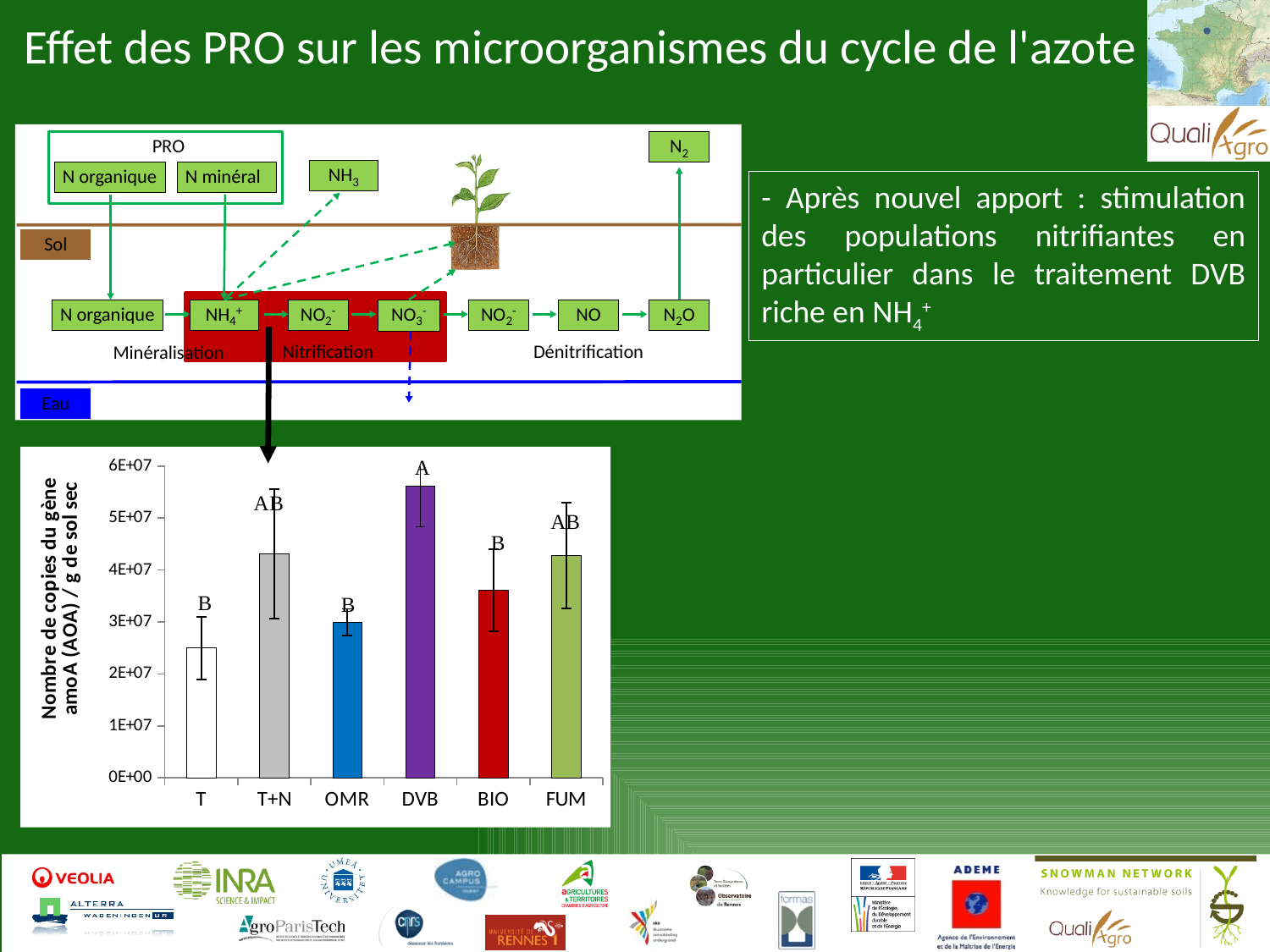
Is the value for BIO greater or less than 3E+07? greater Which treatment has the highest number of amoA gene copies in the bar chart? DVB Which has a larger value in the bar chart, DVB or BIO? DVB What kind of chart is shown on the slide? bar chart How many treatments (categories) are shown on the x axis of the bar chart? 6 Is the value for BIO greater or less than 4E+07? less Is the value for DVB greater or less than 5E+07? greater Which has a larger value in the bar chart, T or OMR? OMR What statistical group letter is printed above the DVB bar? A Which treatment has the lowest number of amoA gene copies in the bar chart? T